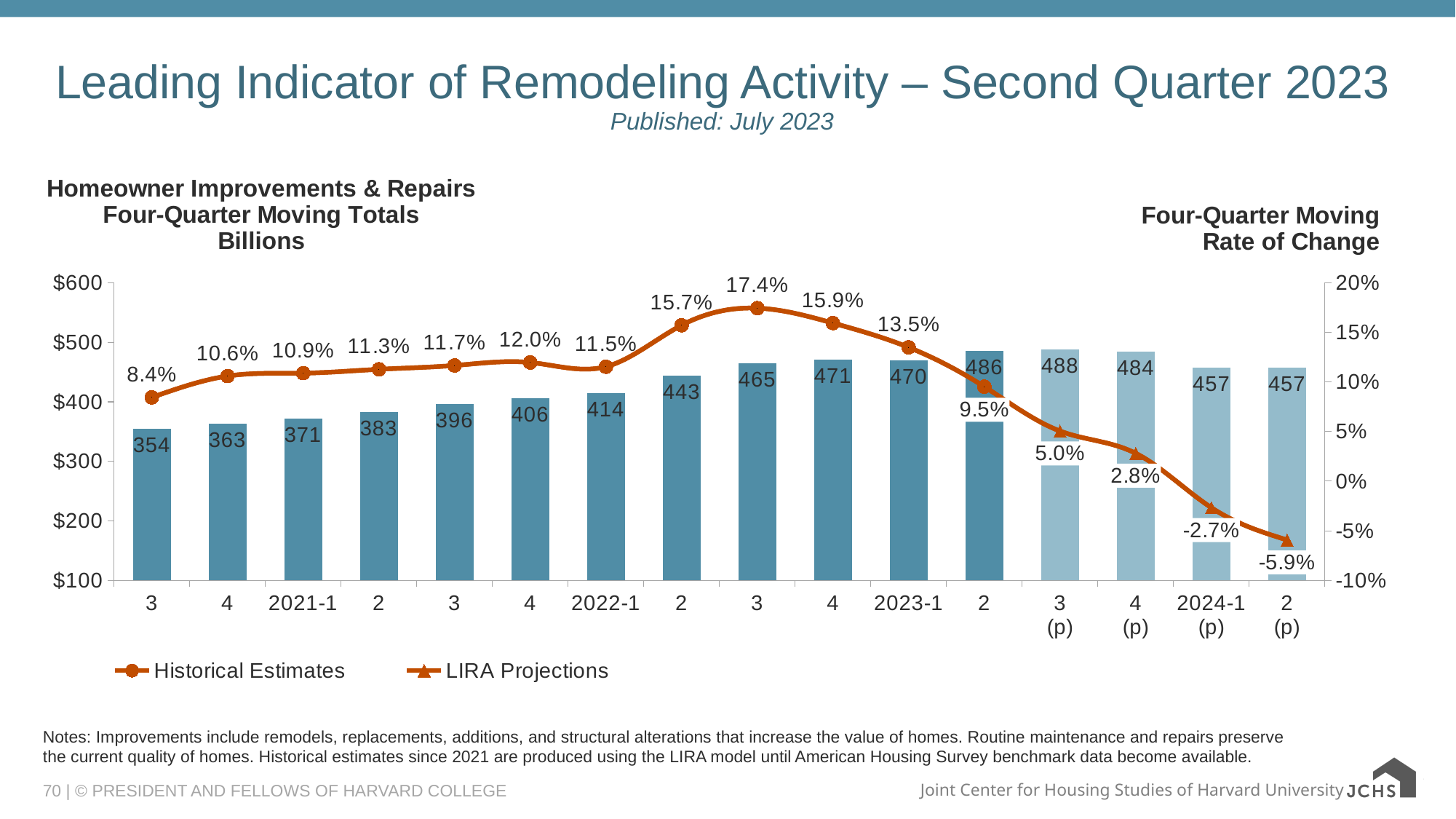
Which has the larger four-quarter moving total, 2022-1 or 2022 quarter 2? 2022 quarter 2 Which quarter has the highest four-quarter moving rate of change on the line? 2022 quarter 3 (17.4%) How many quarters are plotted along the x axis? 16 What is the projected four-quarter moving rate of change for 2024-1 (p)? -2.7% Which quarter has the tallest bar for four-quarter moving totals? 2023 quarter 3 (p), 488 What is the four-quarter moving total (in billions) for 2023-1? 470 What is the difference between the four-quarter moving totals for 2023 quarter 2 (486) and 2023-1 (470)? 16 What is the value of the lowest bar, the first bar on the left? 354 Does the four-quarter moving rate of change rise or fall from 2023-1 through 2024 quarter 2 (p)? Fall How many series does the legend list? 2 What is the four-quarter moving rate of change for the third quarter of 2022 (2022 bar labeled 3)? 17.4% What kind of chart is shown on the slide? Combined bar chart and line chart